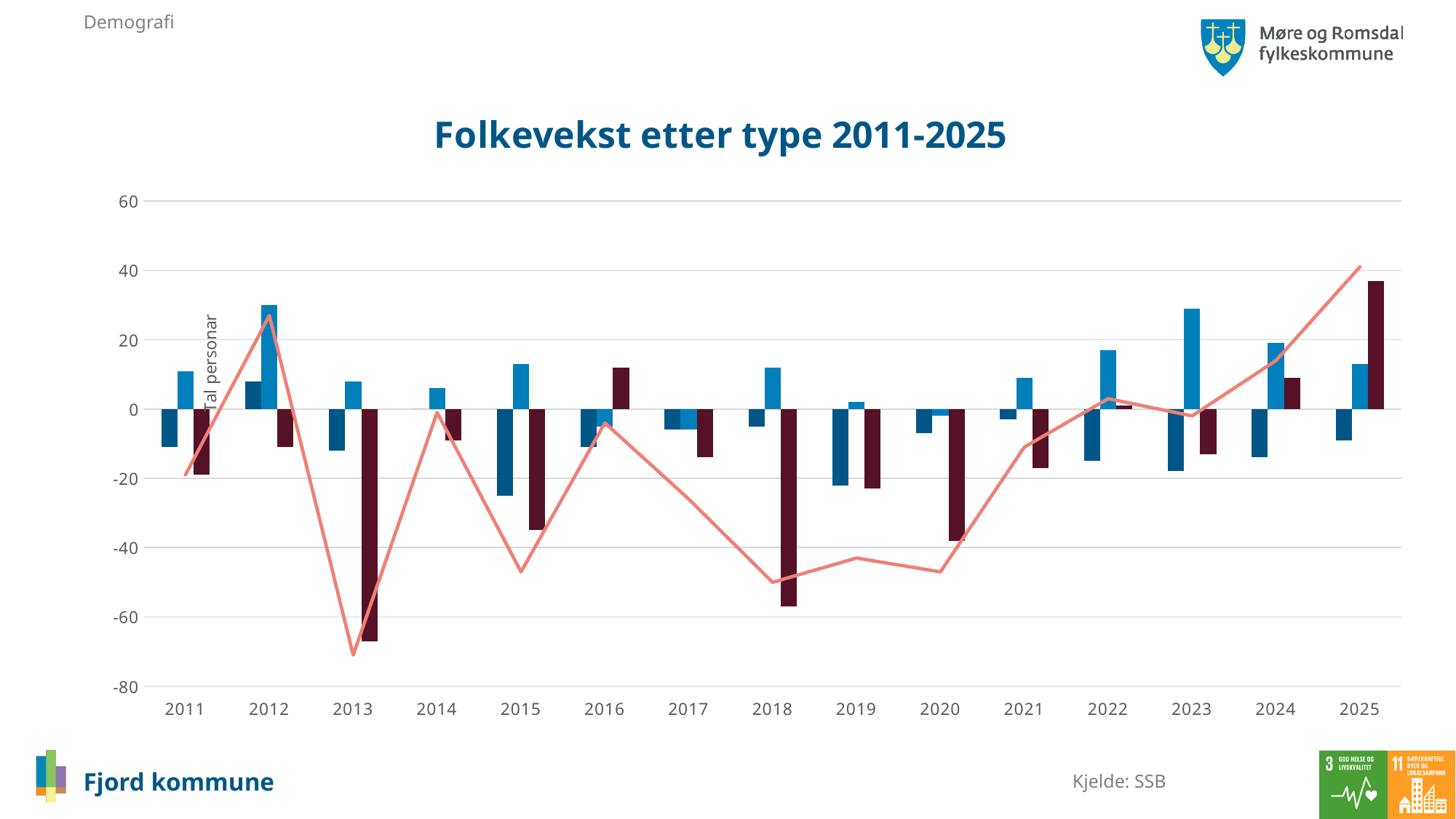
Is the value of the line for 2013 greater or less than -60? less Is the value of the light blue bar for 2023 greater or less than 20? greater In which year does the line reach its lowest point? 2013 In which year does the line reach its highest point? 2025 What kind of chart is shown on the slide? Combined bar and line chart What is the title of the chart? Folkevekst etter type 2011-2025 Is the value of the dark red bar for 2013 greater or less than -60? less How many years are shown on the x axis of the chart? 15 Which year has the lower dark red bar, 2013 or 2018? 2013 What is the label on the vertical axis of the chart? Tal personar